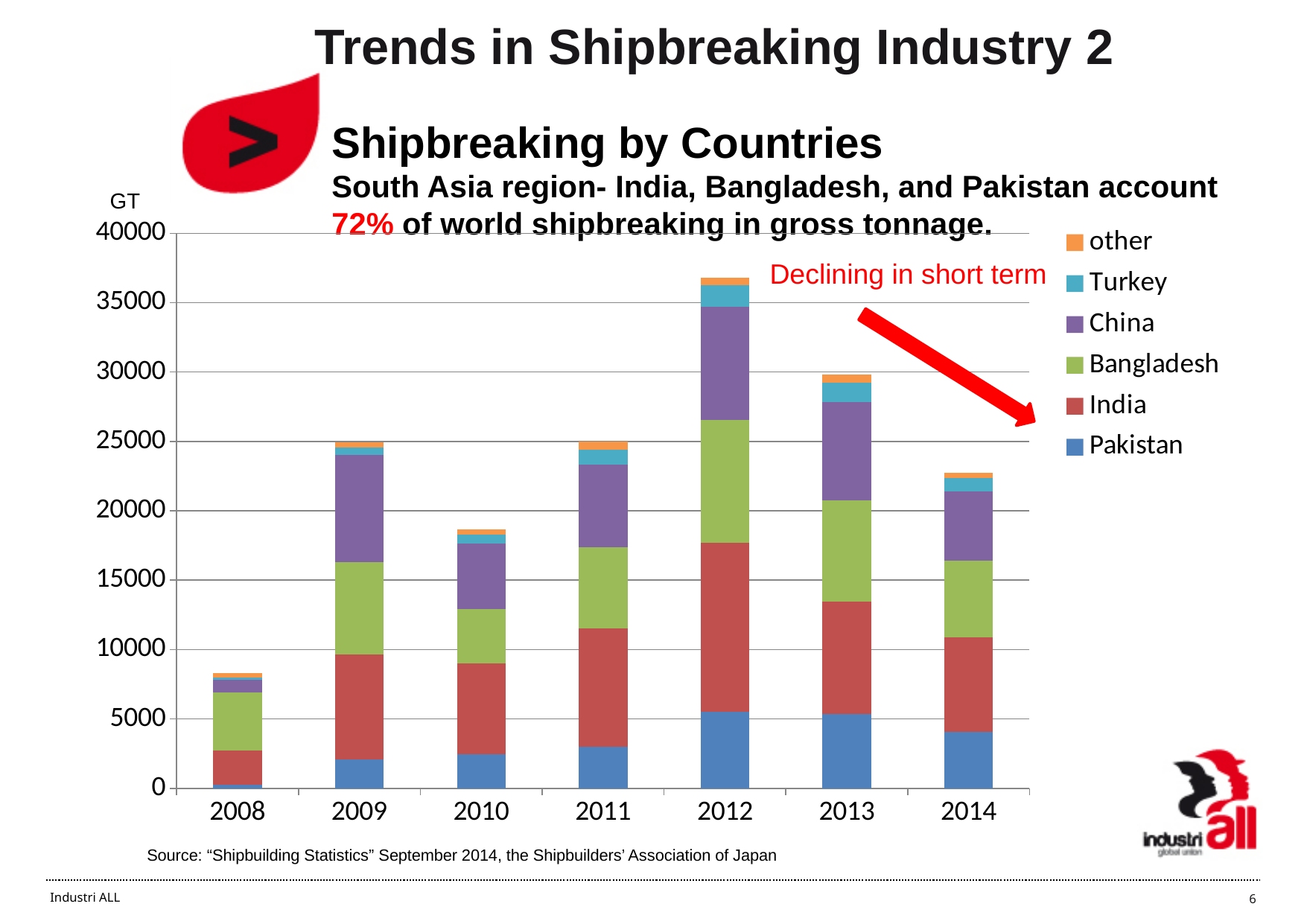
Which year has the larger total stacked bar, 2009 or 2010? 2009 What kind of chart is shown on the slide? Stacked bar chart Do the total values rise or fall from 2012 to 2014? Fall Is the total value for 2014 greater or less than 20000? greater How many series does the chart's legend list? 6 Which year has the lowest total stacked bar? 2008 Is the total value for 2010 greater or less than 20000? less Which colour represents Pakistan in the chart's legend? Blue Which year has the highest total stacked bar? 2012 How many years are shown on the x axis of the chart? 7 Is the total value for 2008 greater or less than 10000? less